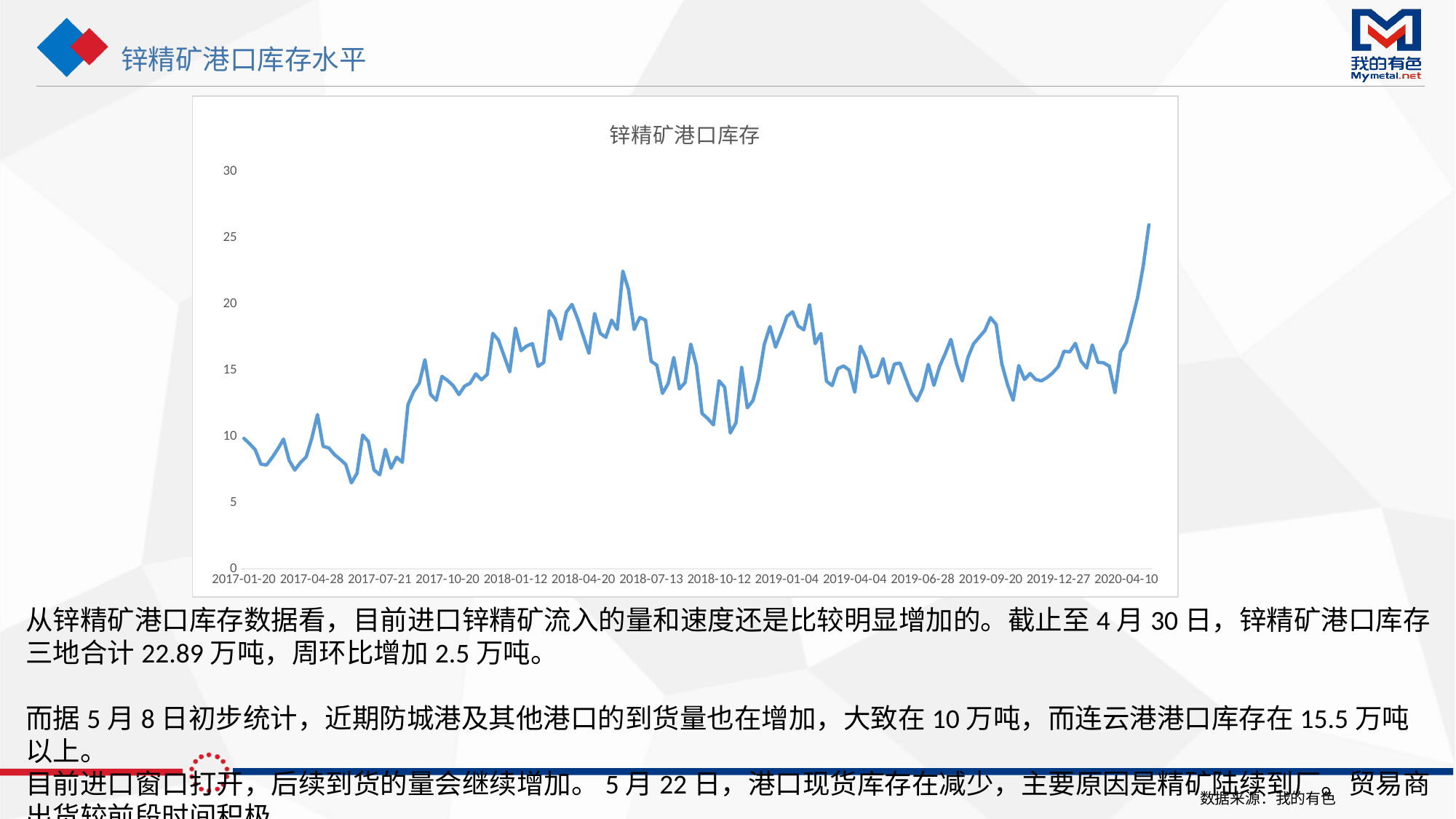
Is the value at 2019-09-20 greater or less than 15? greater Is the value at 2017-07-21 greater or less than 10? less Is the value at 2019-01-04 greater or less than 15? greater What is the highest value shown on the y axis? 30 Overall, does the plotted value rise or fall from the start of the x axis to the end? rise How many date labels are shown on the x axis? 14 What kind of chart is shown on the slide? line chart What is the title of the chart? 锌精矿港口库存